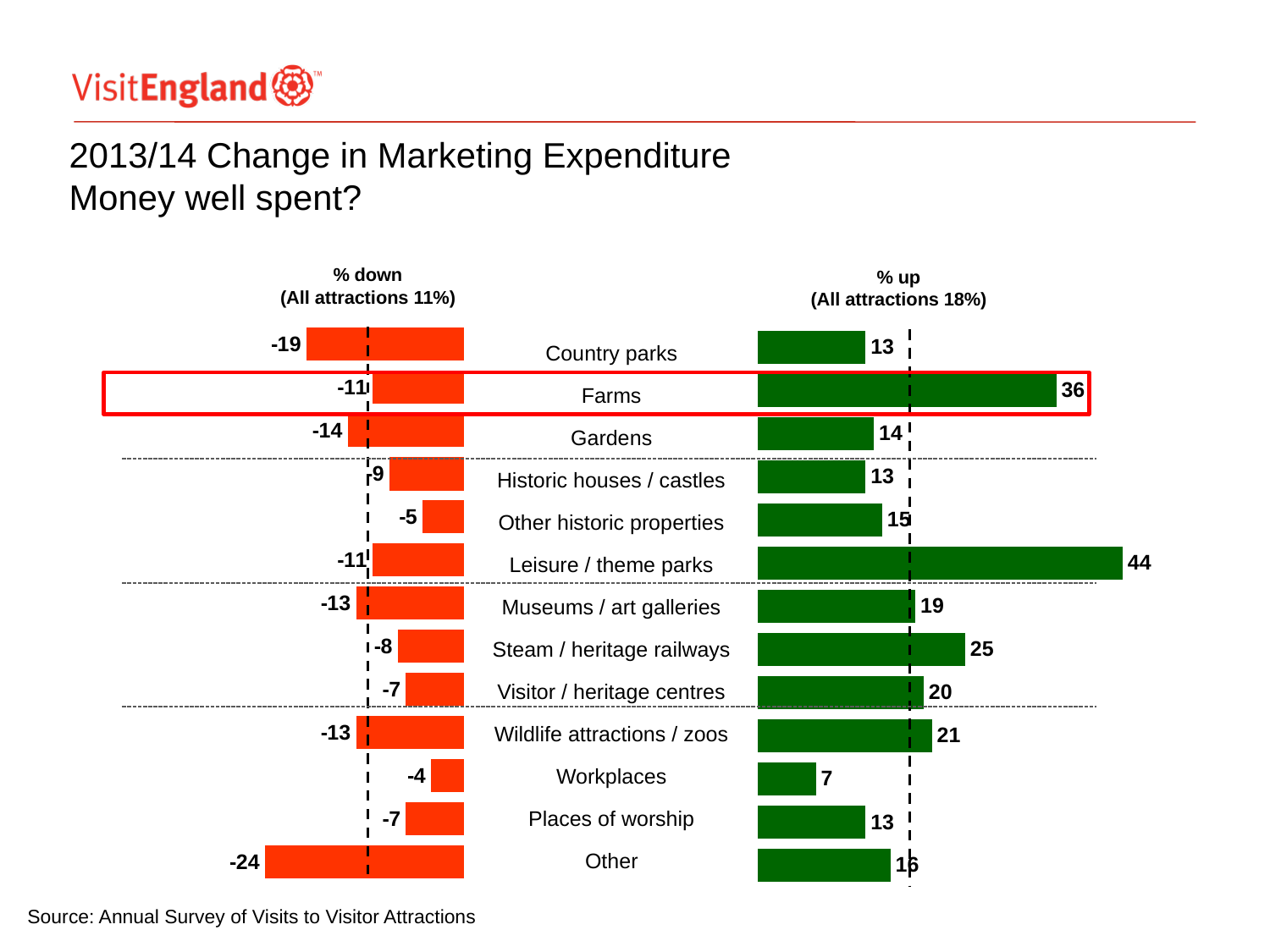
In the "% down" chart, what is the value for Other? -24 In the "% up" chart, what is the value for Farms? 36 What kind of chart is the "% down" chart? Bar chart How many categories are shown in the "% up" chart? 13 In the "% up" chart, which category has the lowest value? Workplaces In the "% down" chart, what is the value for Workplaces? -4 In the "% up" chart, which category has the highest value? Leisure / theme parks In the "% up" chart, what is the difference between Farms and Country parks? 23 In the "% down" chart, which category has the largest decrease? Other According to the "% up" chart heading, what is the value for all attractions? 18% In the "% up" chart, what is the value for Leisure / theme parks? 44 In the "% up" chart, which is larger, Steam / heritage railways or Museums / art galleries? Steam / heritage railways